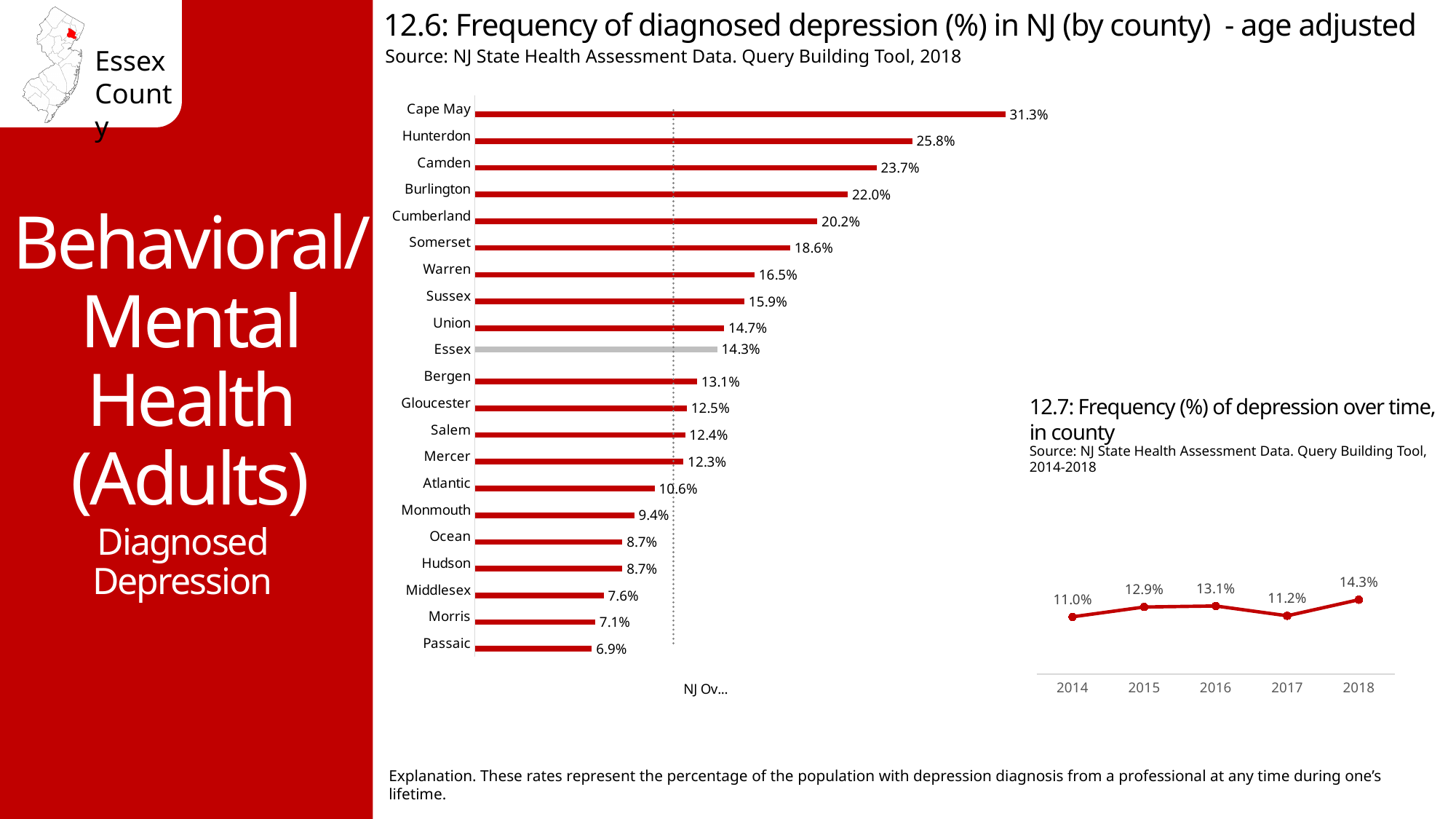
In the chart 12.6 (Frequency of diagnosed depression by county), which county has the lowest value? Passaic What kind of chart is 12.6 (Frequency of diagnosed depression by county)? Bar chart In the chart 12.7 (Frequency of depression over time, in county), what is the value for 2016? 13.1% In the chart 12.6 (Frequency of diagnosed depression by county), how many counties are plotted? 21 In the chart 12.6 (Frequency of diagnosed depression by county), which county has the highest value? Cape May In the chart 12.6 (Frequency of diagnosed depression by county), what is the value for Atlantic? 10.6% In the chart 12.6 (Frequency of diagnosed depression by county), what is the difference between Cape May and Passaic? 24.4% In the chart 12.6 (Frequency of diagnosed depression by county), which is larger, Camden or Somerset? Camden In the chart 12.6 (Frequency of diagnosed depression by county), what is the value for Essex? 14.3% What kind of chart is 12.7 (Frequency of depression over time, in county)? Line chart In the chart 12.7 (Frequency of depression over time, in county), which year has the highest value? 2018 In the chart 12.7 (Frequency of depression over time, in county), what is the difference between 2018 and 2014? 3.3%